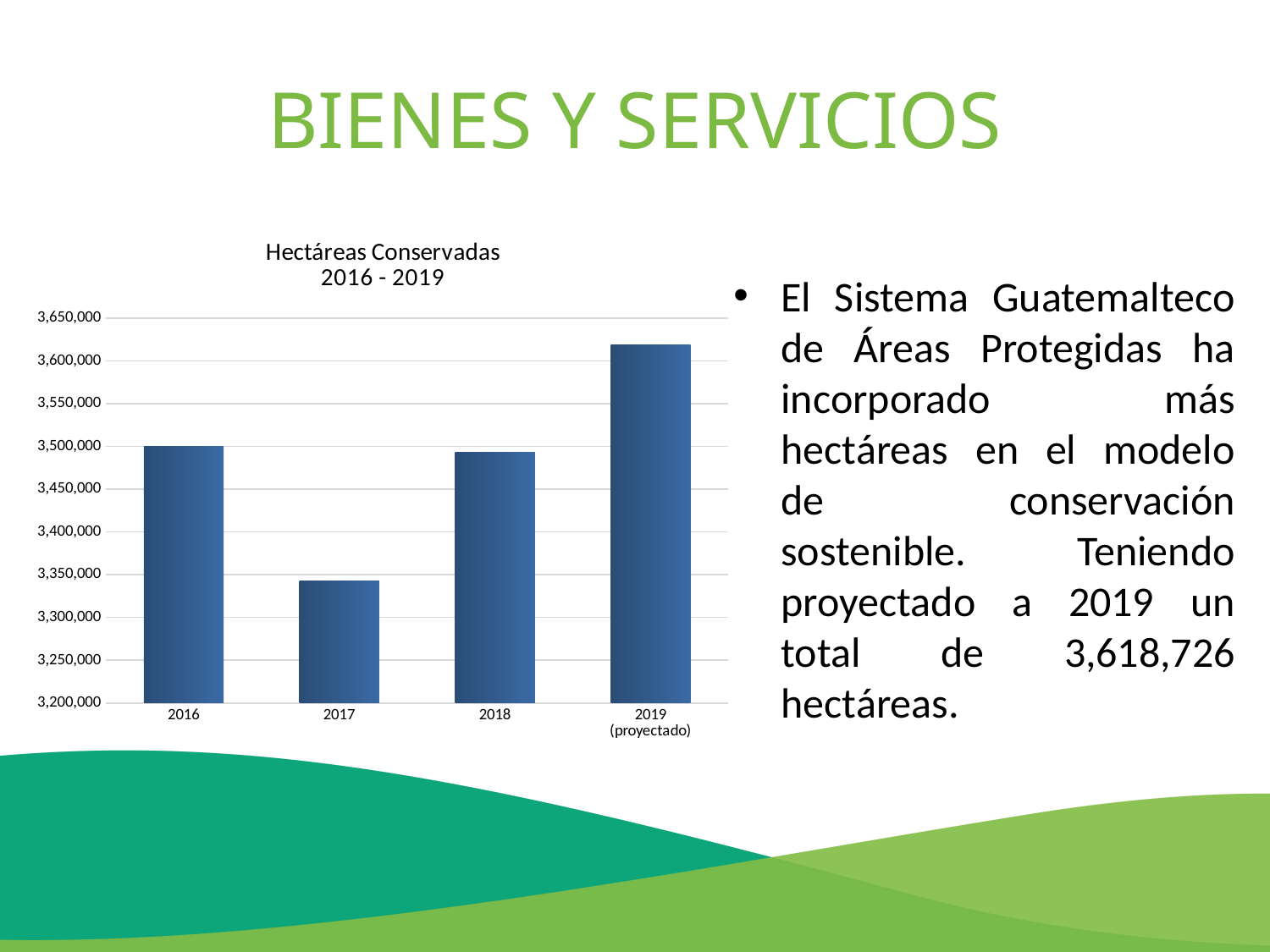
Is the value for 2018 greater or less than 3,450,000? greater How many years (categories) are plotted in the chart? 4 Which year has the lowest value in the chart? 2017 What is the lowest value shown on the chart's vertical axis? 3,200,000 What kind of chart is shown on the slide? bar chart What is the title of the chart? Hectáreas Conservadas 2016 - 2019 Is the value for 2017 greater or less than 3,400,000? less Which year has the highest value in the chart? 2019 (proyectado) Which is larger, the value for 2017 or the value for 2018? 2018 Is the value for 2019 (proyectado) greater or less than 3,600,000? greater Do the values rise or fall from 2017 to 2019 (proyectado)? rise Which is larger, the value for 2016 or the value for 2017? 2016